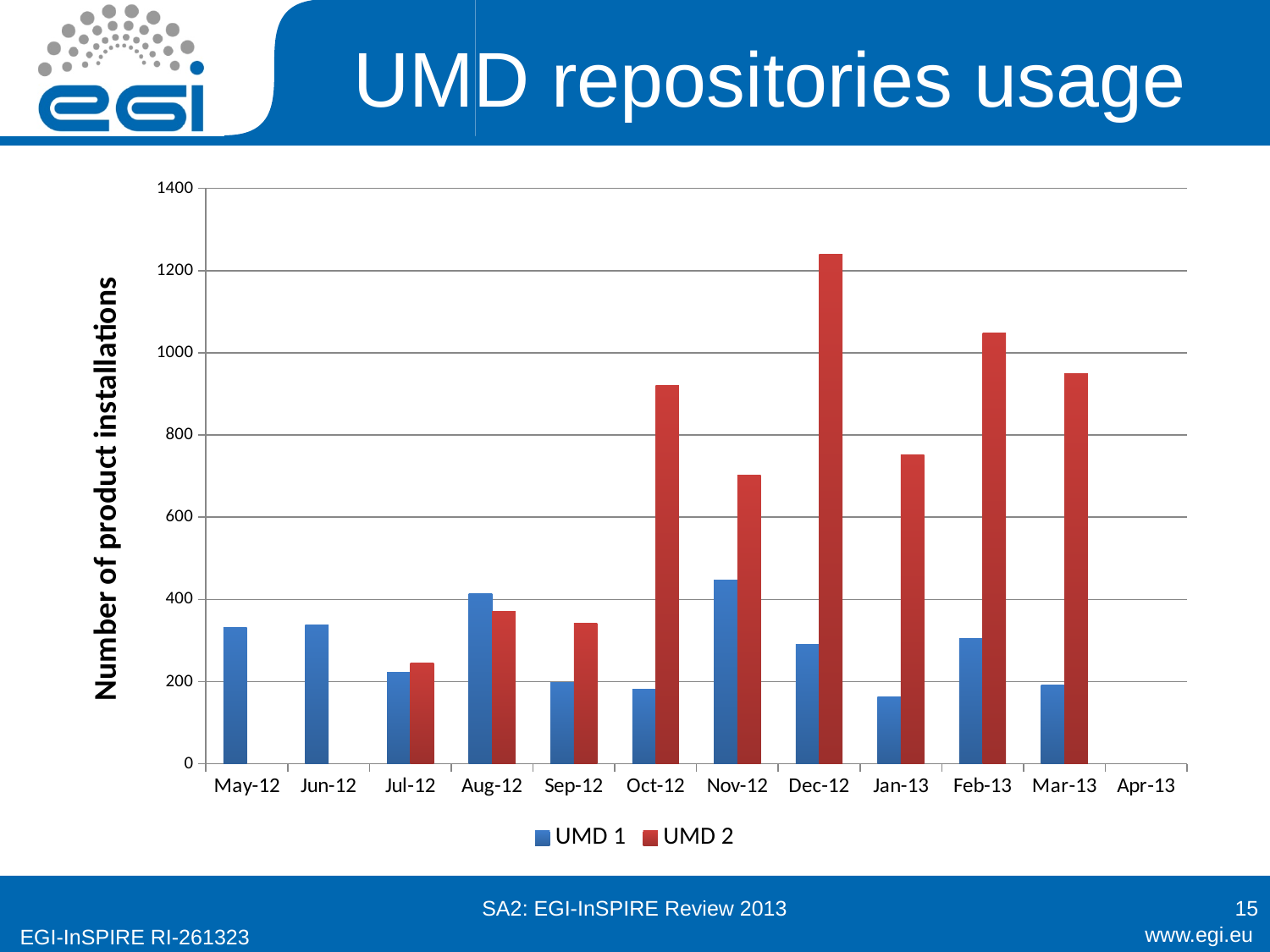
What is the label of the vertical axis? Number of product installations Is the UMD 1 value for Jan-13 greater or less than 200? less Is the UMD 2 value for Oct-12 greater or less than 800? greater Is the UMD 2 value for Dec-12 greater or less than 1200? greater What kind of chart is shown on the slide? bar chart How many months are shown on the x axis? 12 In which month is the UMD 2 value lowest (among months where UMD 2 is plotted)? Jul-12 Do the UMD 2 values rise or fall from Jul-12 to Oct-12? rise In Oct-12, which series has the larger value, UMD 1 or UMD 2? UMD 2 In which month is the UMD 2 value highest? Dec-12 How many series does the legend list? 2